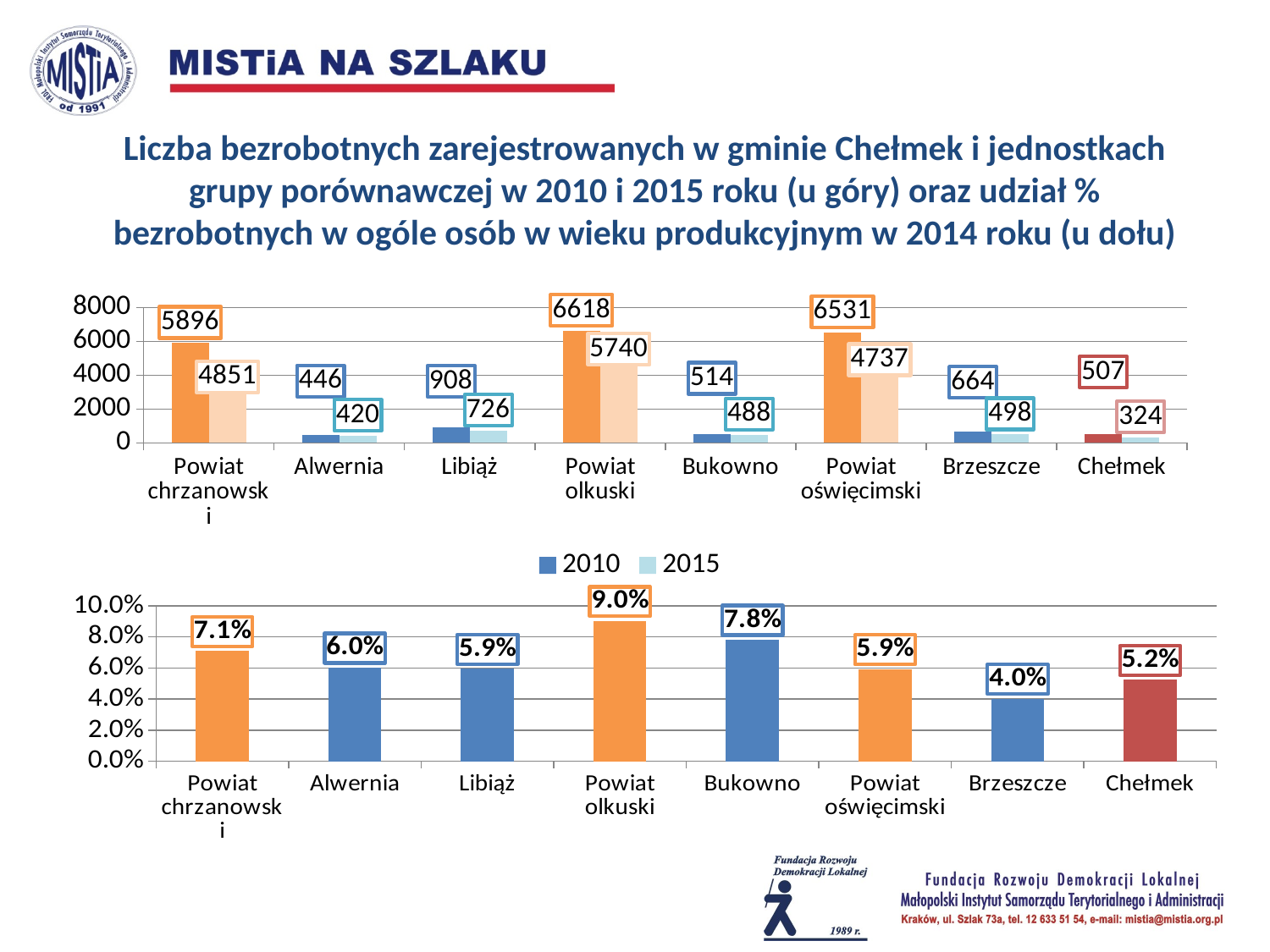
In the bottom chart, what is the share of unemployed among working-age people in Chełmek? 5.2% In the bottom chart, which category has the lowest percentage? Brzeszcze In the top chart, what was the number of registered unemployed in Chełmek in 2015? 324 In the bottom chart, which category has the highest percentage? Powiat olkuski In the top chart, which category had the lowest value in 2015? Chełmek In the top chart, what was the 2015 value for Powiat olkuski? 5740 In the top chart, how many series does the legend list? 2 In the top chart, by how much did the number of unemployed in Chełmek fall between 2010 and 2015? 183 How many categories are shown on the x axis of the bottom chart? 8 In the top chart, which category had the highest value in 2010? Powiat olkuski In the bottom chart, which is larger: the value for Bukowno or the value for Alwernia? Bukowno In the top chart, what was the number of registered unemployed in Chełmek in 2010? 507